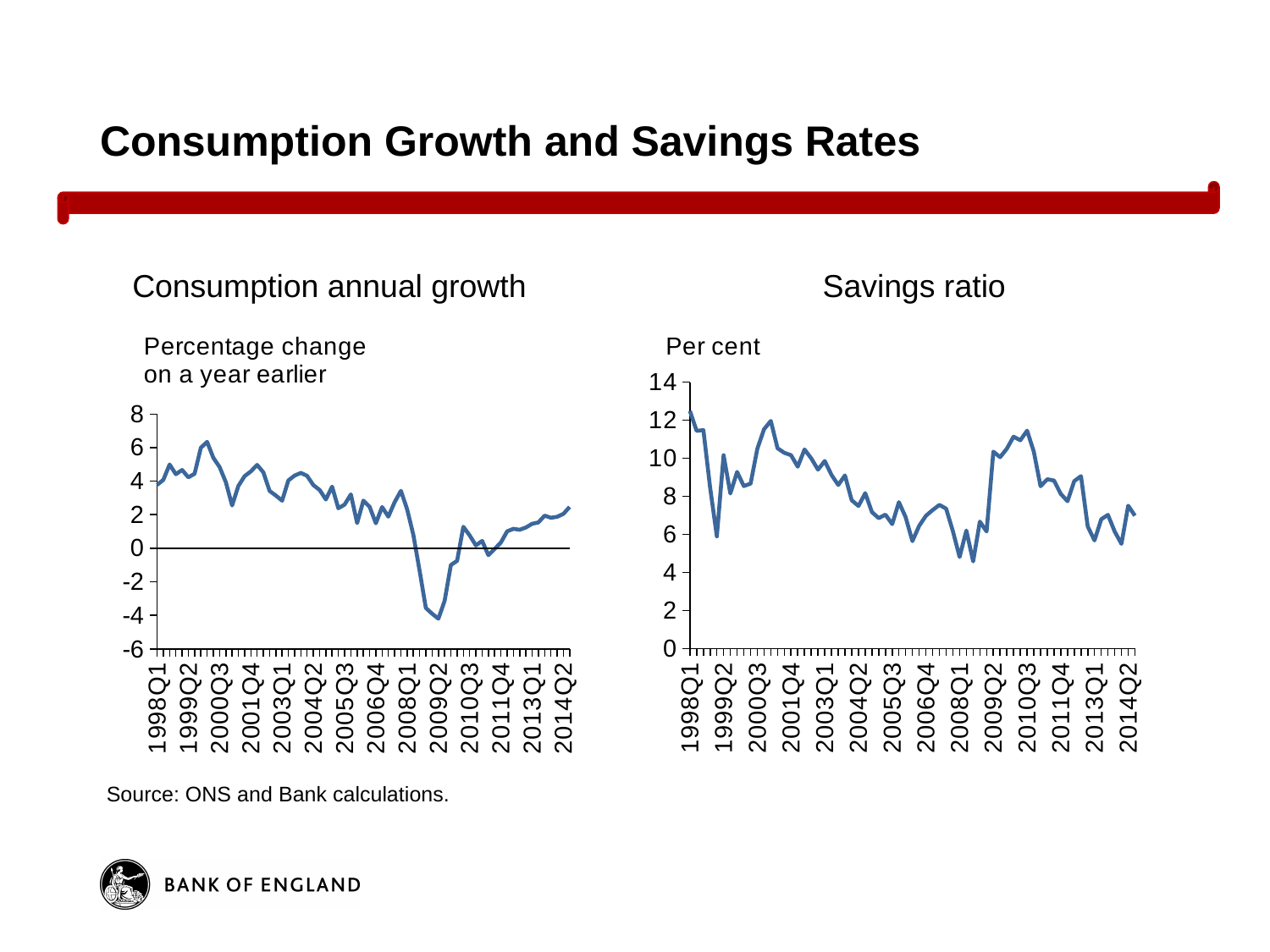
What is the y-axis label of the Savings ratio chart? Per cent In the Savings ratio chart, is the value for 2014Q2 greater or less than 10? less In the Consumption annual growth chart, is the value for 2009Q2 greater or less than -2? less In the Consumption annual growth chart, do values generally rise or fall between 2009Q2 and 2014Q2? rise What is the highest value shown on the y-axis of the Savings ratio chart? 14 In the Savings ratio chart, do values generally rise or fall between 2000Q3 and 2008Q1? fall In the Savings ratio chart, is the value for 2010Q3 greater or less than 10? greater What kind of chart is the Savings ratio chart? line chart What kind of chart is the Consumption annual growth chart? line chart